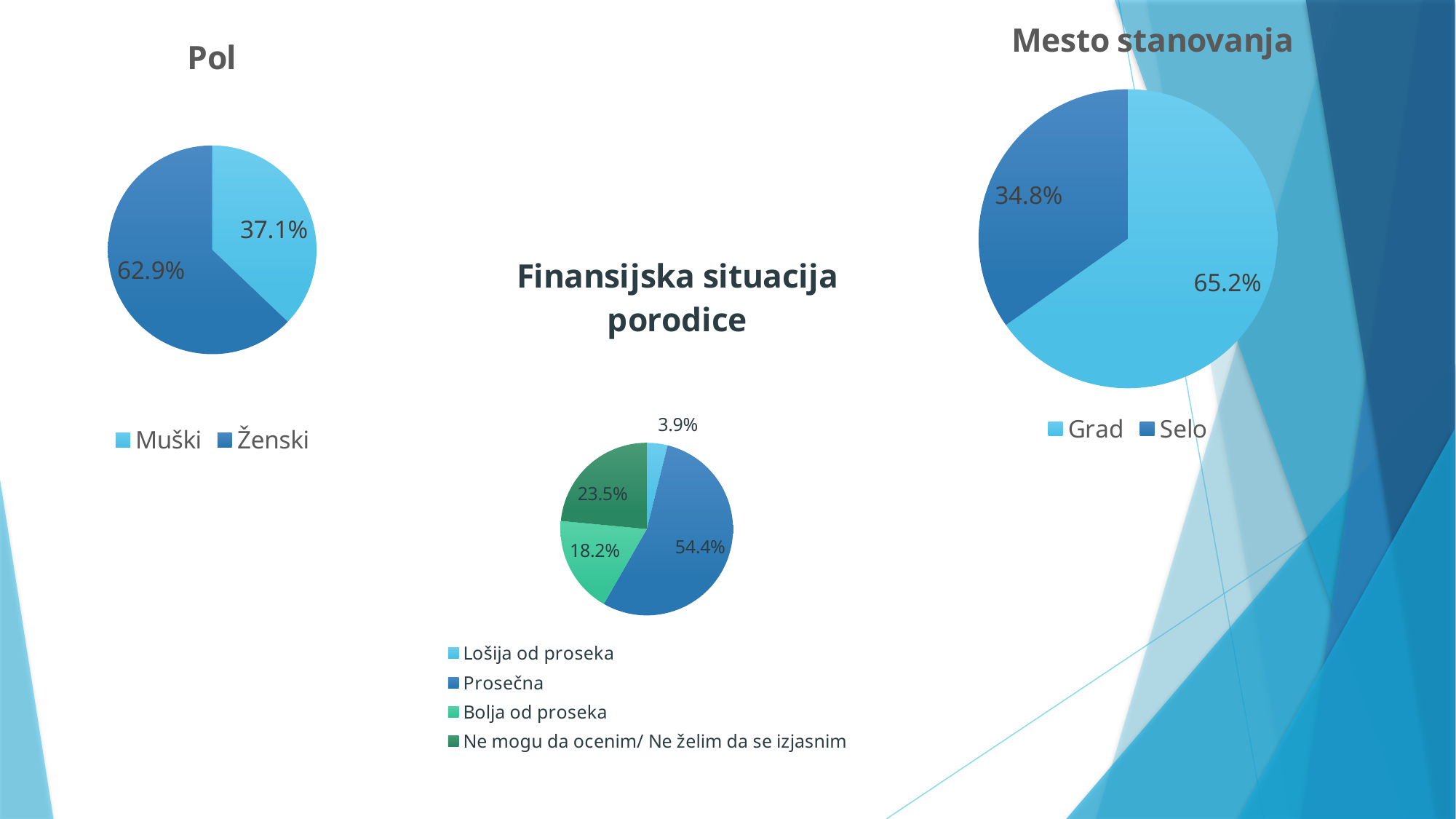
What type of chart is the 'Mesto stanovanja' chart? Pie chart In the 'Finansijska situacija porodice' chart, what share is Lošija od proseka? 3.9% In the 'Pol' chart, what share is Ženski? 62.9% In the 'Pol' chart, what share is Muški? 37.1% In the 'Finansijska situacija porodice' chart, how many categories does the legend list? 4 In the 'Pol' chart, what is the difference between the Ženski and Muški shares? 25.8% In the 'Finansijska situacija porodice' chart, which category has the largest share? Prosečna In the 'Finansijska situacija porodice' chart, what share is Prosečna? 54.4% In the 'Mesto stanovanja' chart, which category has the smaller share? Selo In the 'Mesto stanovanja' chart, what share is Selo? 34.8% In the 'Mesto stanovanja' chart, what share is Grad? 65.2% In the 'Pol' chart, which category has the larger share? Ženski